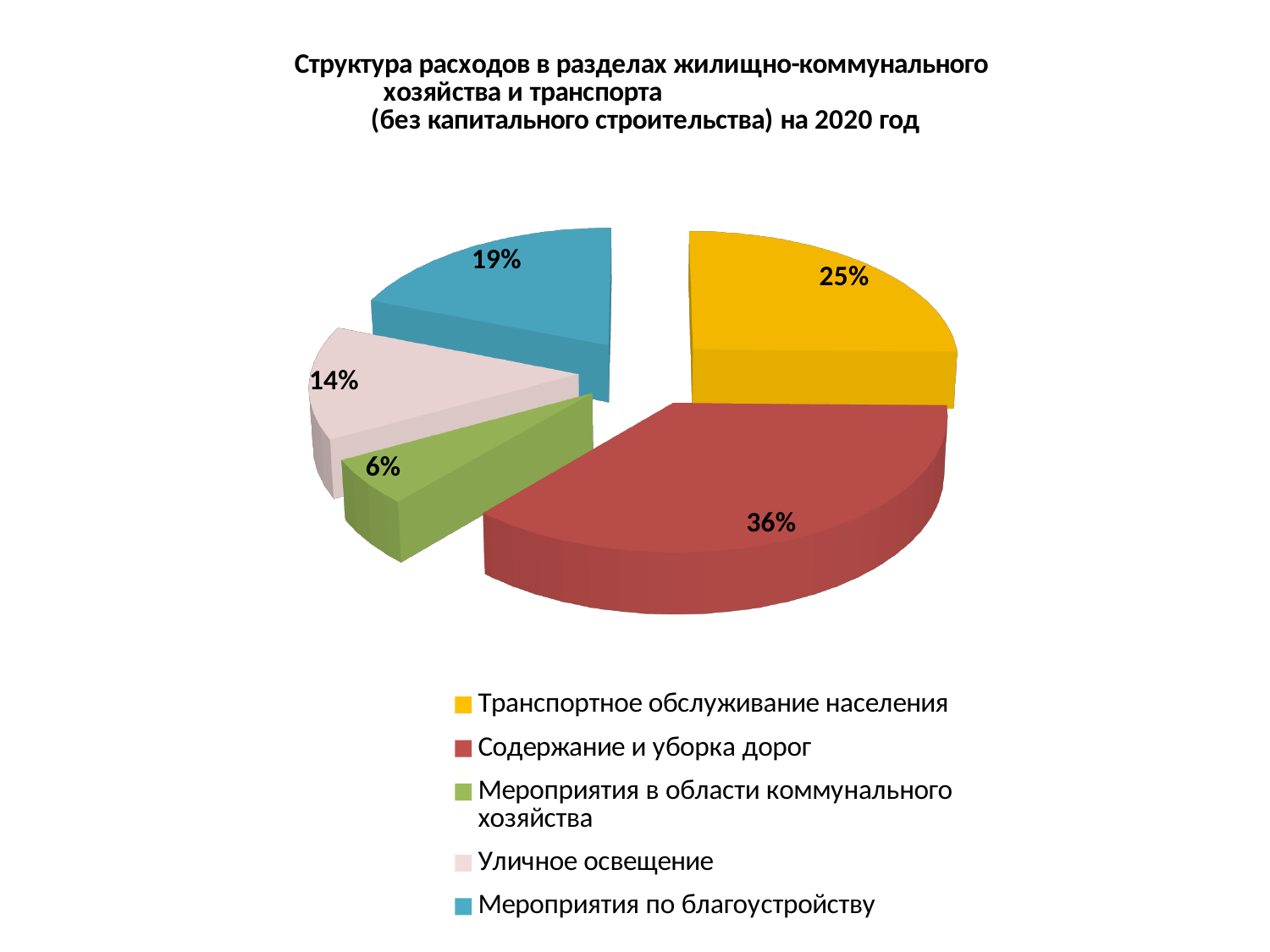
What colour is the slice for Содержание и уборка дорог? Red What is the difference in percentage points between Содержание и уборка дорог and Транспортное обслуживание населения? 11 How many categories does the pie chart show? 5 Which category has the largest share of expenses? Содержание и уборка дорог What share of expenses is for Уличное освещение? 14% Which category has the smallest share of expenses? Мероприятия в области коммунального хозяйства What share of expenses is for Транспортное обслуживание населения? 25% What share of expenses is for Мероприятия по благоустройству? 19% Which is larger: the share for Уличное освещение or the share for Мероприятия по благоустройству? Мероприятия по благоустройству What share of expenses is for Мероприятия в области коммунального хозяйства? 6% What kind of chart is shown on the slide? Pie chart What share of expenses is for Содержание и уборка дорог? 36%